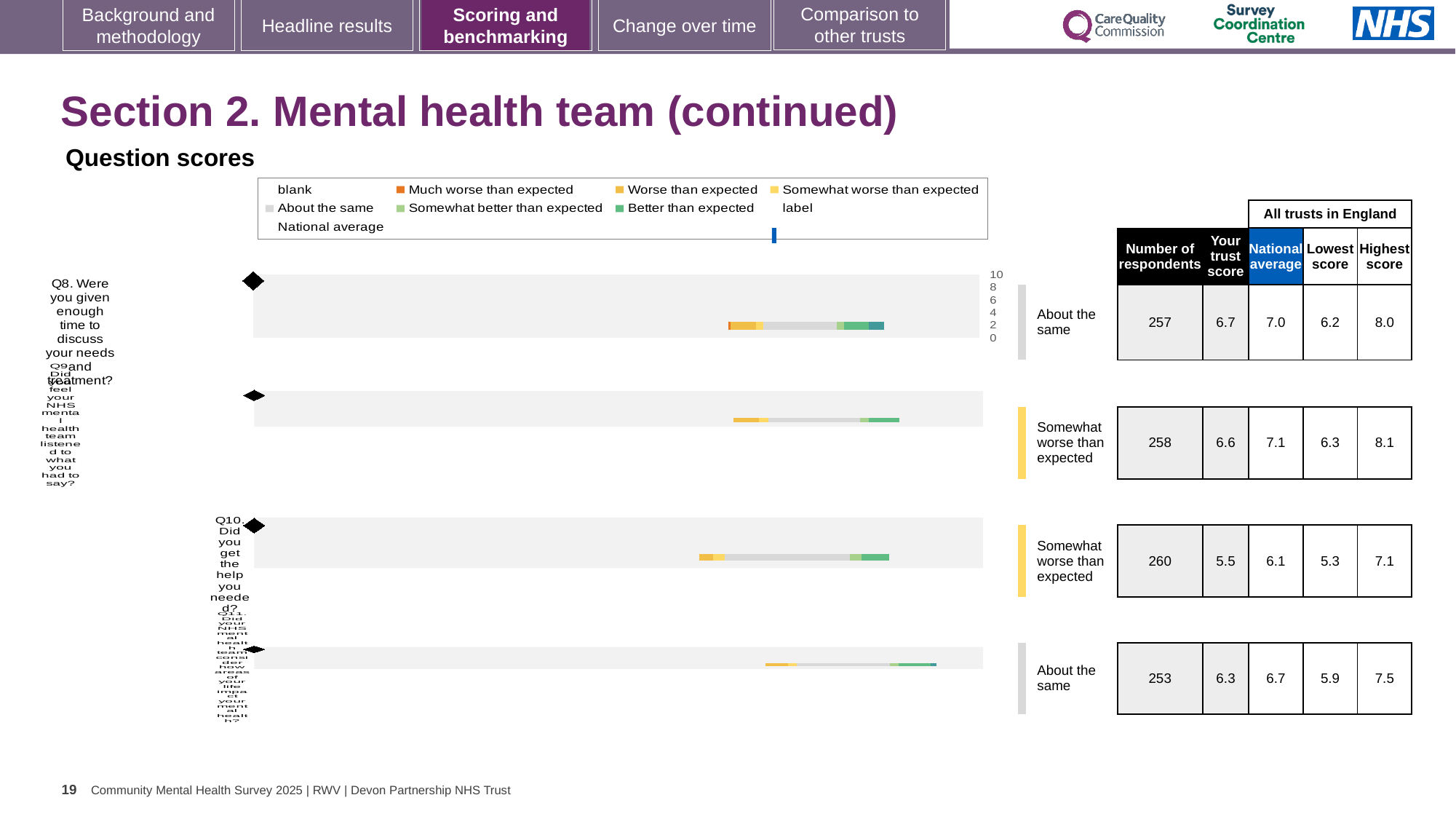
What benchmark category is shown next to the Q10 chart? Somewhat worse than expected In the legend, what colour represents 'Much worse than expected'? orange What kind of chart is used to show the Q8 question score? bar chart How many question charts (Q8 to Q11) are shown on the slide? 4 In the legend, what colour represents 'Better than expected'? green For Q9, what is the difference between the highest score (8.1) and the lowest score (6.3) across all trusts in England? 1.8 Which question has the lowest 'Your trust score' on the slide? Q10 For Q8, which is larger: 'Your trust score' or the national average? National average Which question has the highest 'Your trust score' on the slide? Q8 How many respondents answered Q11? 253 For Q10 (Did you get the help you needed?), what is the national average score? 6.1 For Q8 (Were you given enough time to discuss your needs and treatment?), what is 'Your trust score'? 6.7